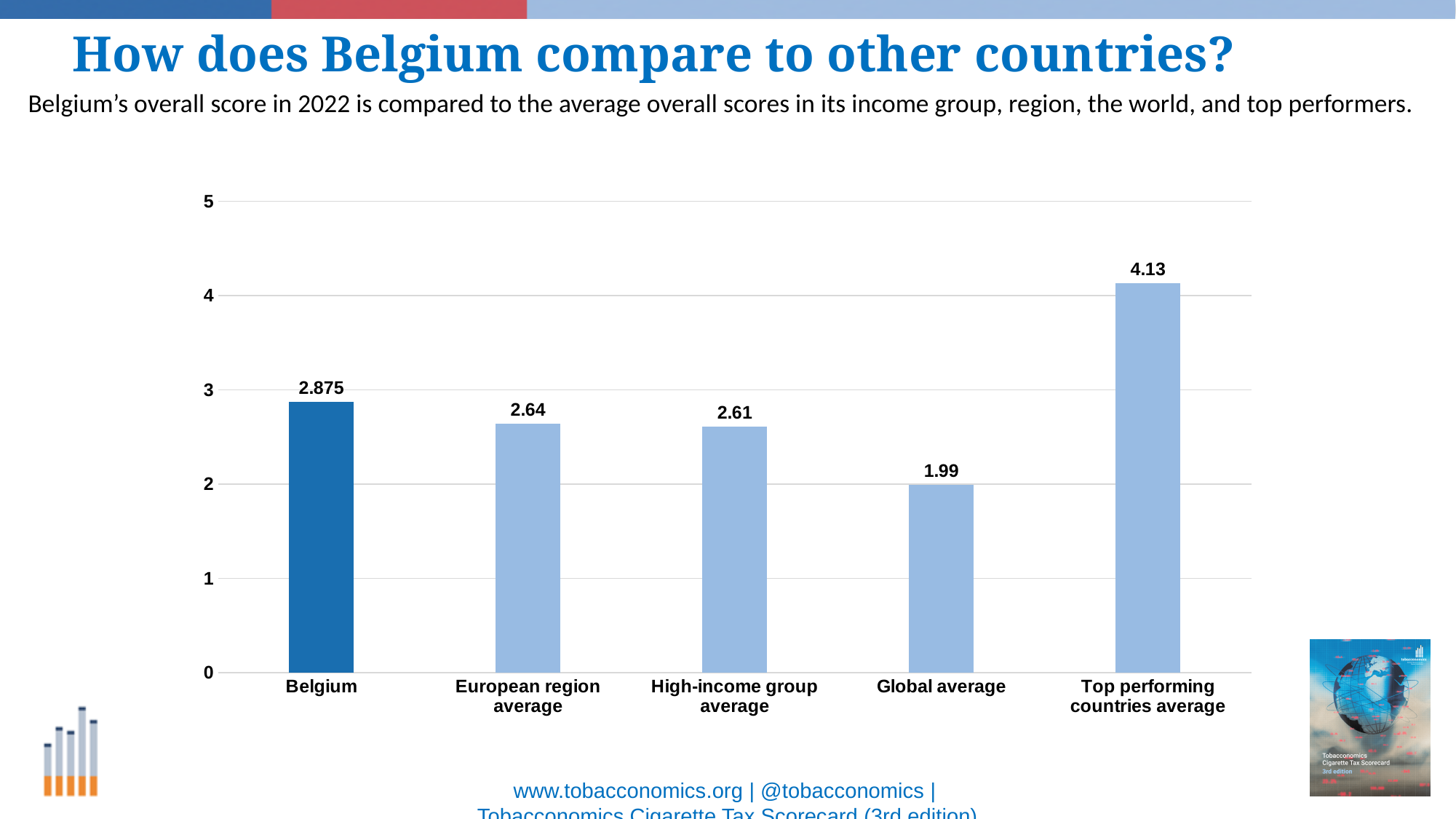
What is the value shown for the Global average? 1.99 Which category has the lowest value? Global average Which category has the highest value? Top performing countries average What is the value shown for Belgium? 2.875 What is the difference between the Top performing countries average and Belgium? 1.255 What is the difference between the High-income group average and the Global average? 0.62 Is the value for the Top performing countries average greater or less than 4? greater What kind of chart is shown on the slide? bar chart Which is larger, the value for Belgium or the Global average? Belgium What is the value shown for the European region average? 2.64 How many categories are shown on the chart? 5 What is the value shown for the Top performing countries average? 4.13